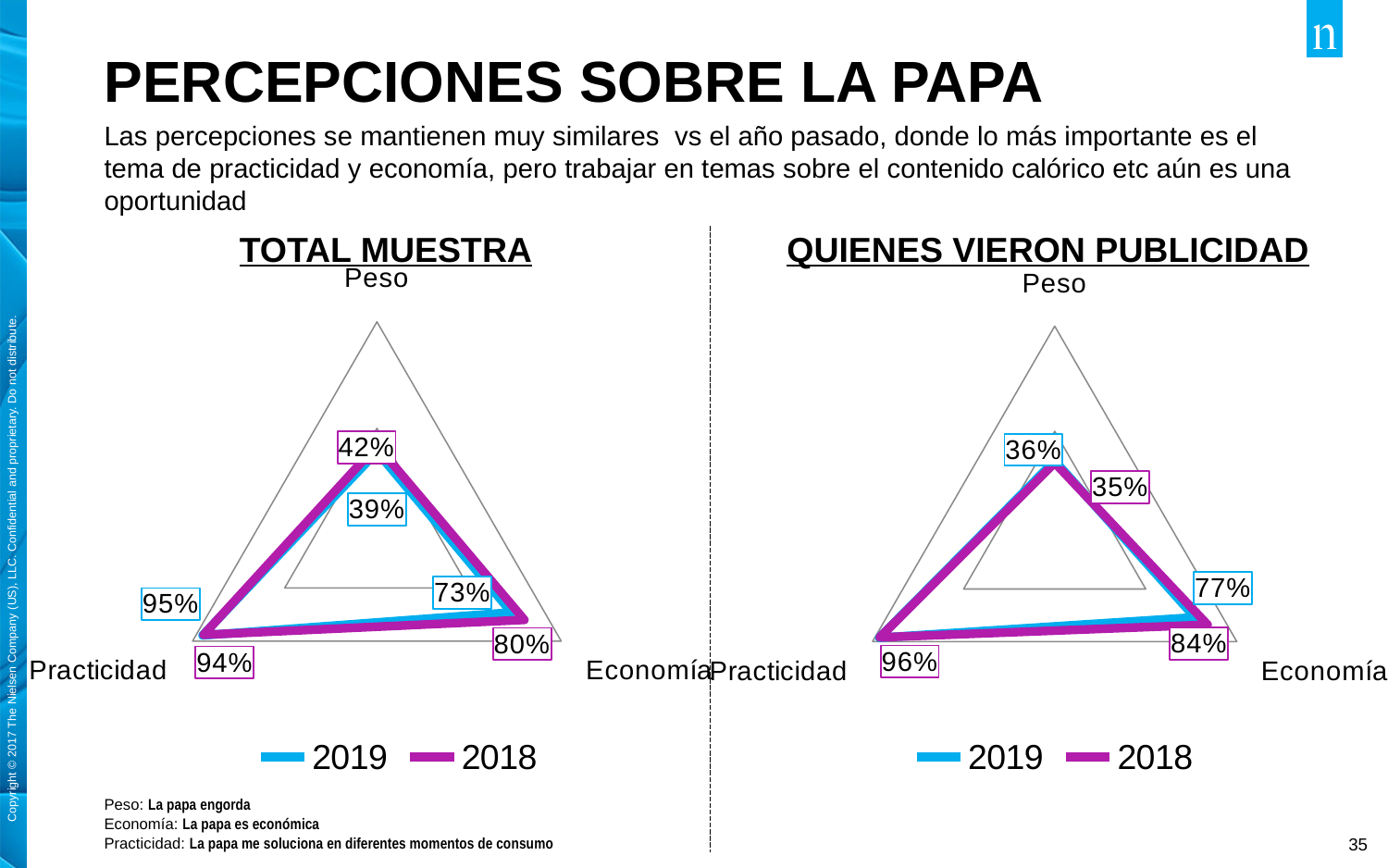
In the TOTAL MUESTRA chart, what is the difference between the 2018 and 2019 values for Economía? 7% How many categories (axes) does each radar chart have? 3 In the QUIENES VIERON PUBLICIDAD chart, which is larger for Economía, the 2019 value or the 2018 value? 2018 In the TOTAL MUESTRA chart, what is the 2018 value for Peso? 42% In the TOTAL MUESTRA chart, what is the 2018 value for Economía? 80% In the TOTAL MUESTRA chart, what is the 2019 value for Peso? 39% In the TOTAL MUESTRA chart, which category has the lowest 2019 value? Peso In the QUIENES VIERON PUBLICIDAD chart, what is the 2018 value for Economía? 84% What type of chart is used on this slide? Radar chart How many series does the legend of the TOTAL MUESTRA chart list? 2 In the QUIENES VIERON PUBLICIDAD chart, what is the 2019 value for Peso? 36% In the TOTAL MUESTRA chart, what is the 2019 value for Practicidad? 95%